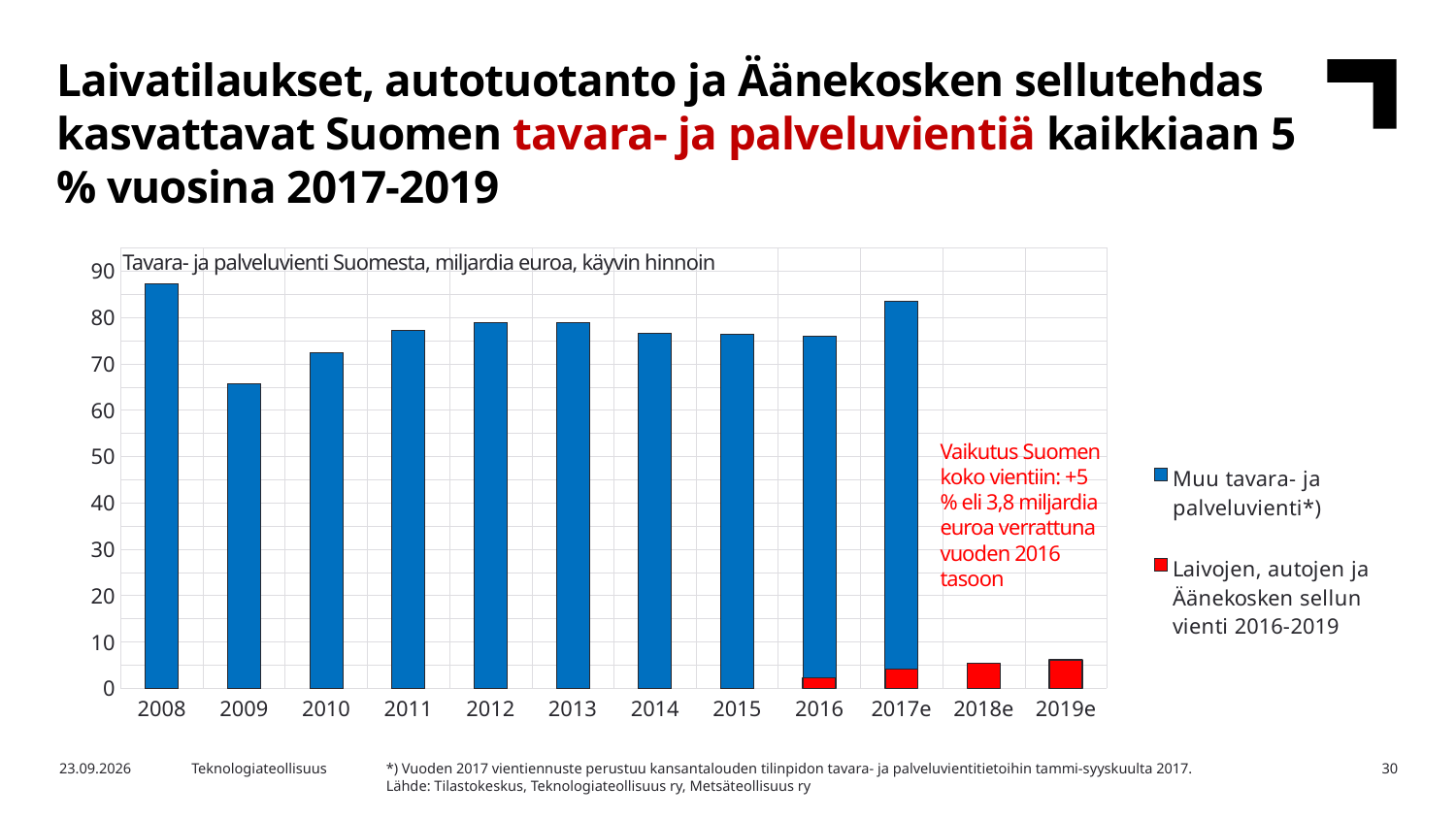
How many years (categories) are shown on the x axis of the chart? 12 How many series does the chart legend list? 2 Does the 'Muu tavara- ja palveluvienti*)' value rise or fall from 2008 to 2009? fall Is the value for 'Muu tavara- ja palveluvienti*)' in 2009 greater or less than 70? less Is the value for 'Muu tavara- ja palveluvienti*)' in 2008 greater or less than 80? greater Which year has the tallest bar for 'Muu tavara- ja palveluvienti*)'? 2008 Which colour represents 'Laivojen, autojen ja Äänekosken sellun vienti 2016-2019' in the chart? red What is the title of the chart? Tavara- ja palveluvienti Suomesta, miljardia euroa, käyvin hinnoin Which is larger, the 'Muu tavara- ja palveluvienti*)' bar for 2008 or for 2009? 2008 Which year has the lowest bar for 'Muu tavara- ja palveluvienti*)' among the years where it is plotted? 2009 What kind of chart is shown on the slide? bar chart Is the value for 'Laivojen, autojen ja Äänekosken sellun vienti 2016-2019' in 2019e greater or less than 10? less